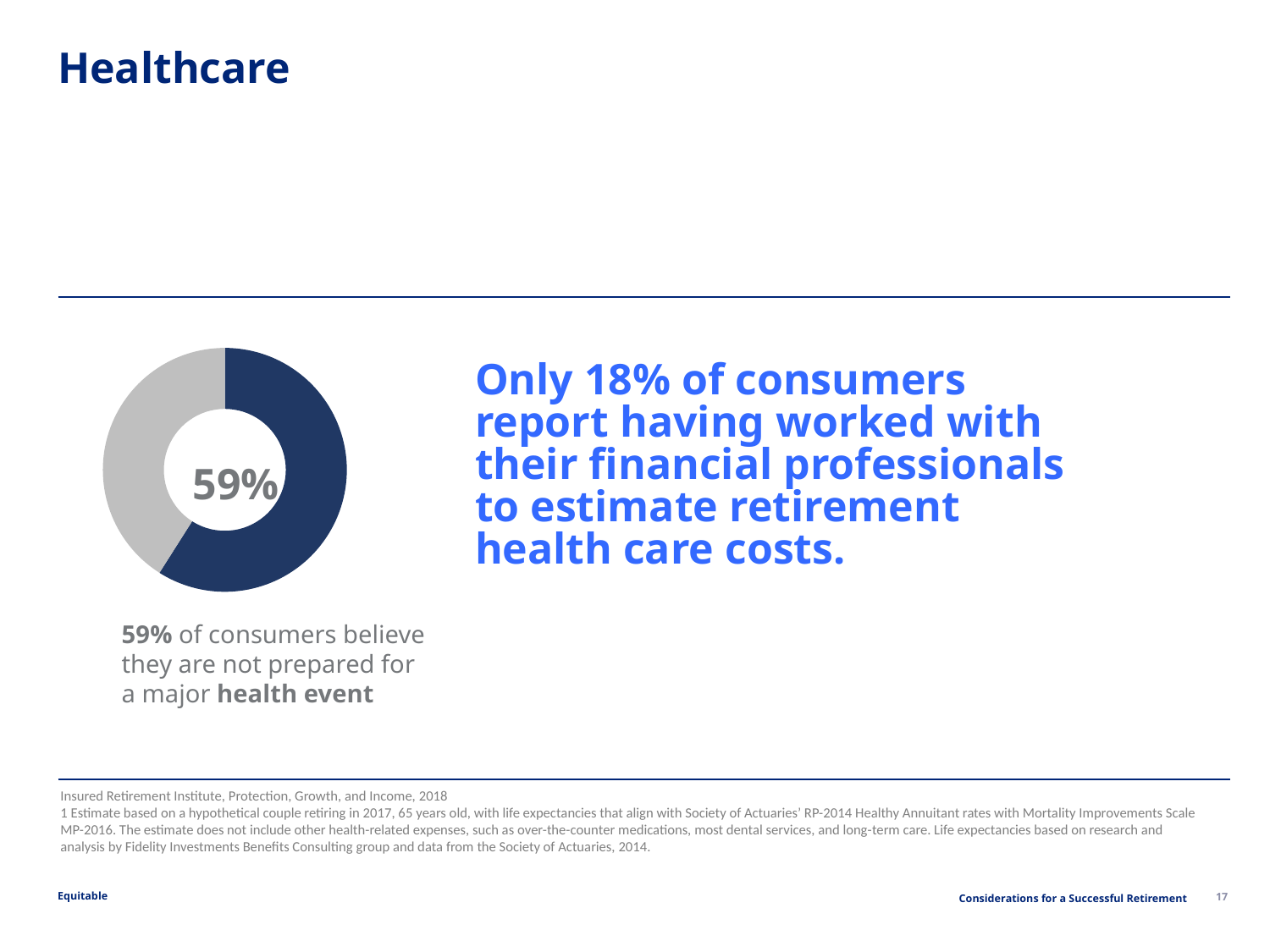
Which slice of the donut chart is larger, the dark blue one or the grey one? The dark blue one According to the caption under the donut chart, what does the 59% represent? Consumers who believe they are not prepared for a major health event Does the dark blue slice of the donut chart cover more or less than half of the chart? More What colour is the larger slice of the donut chart? Dark blue What value is printed in the centre of the donut chart? 59% What kind of chart is shown on the slide? Donut (pie) chart What share of the donut chart does the dark blue slice represent? 59% How many slices does the donut chart have? 2